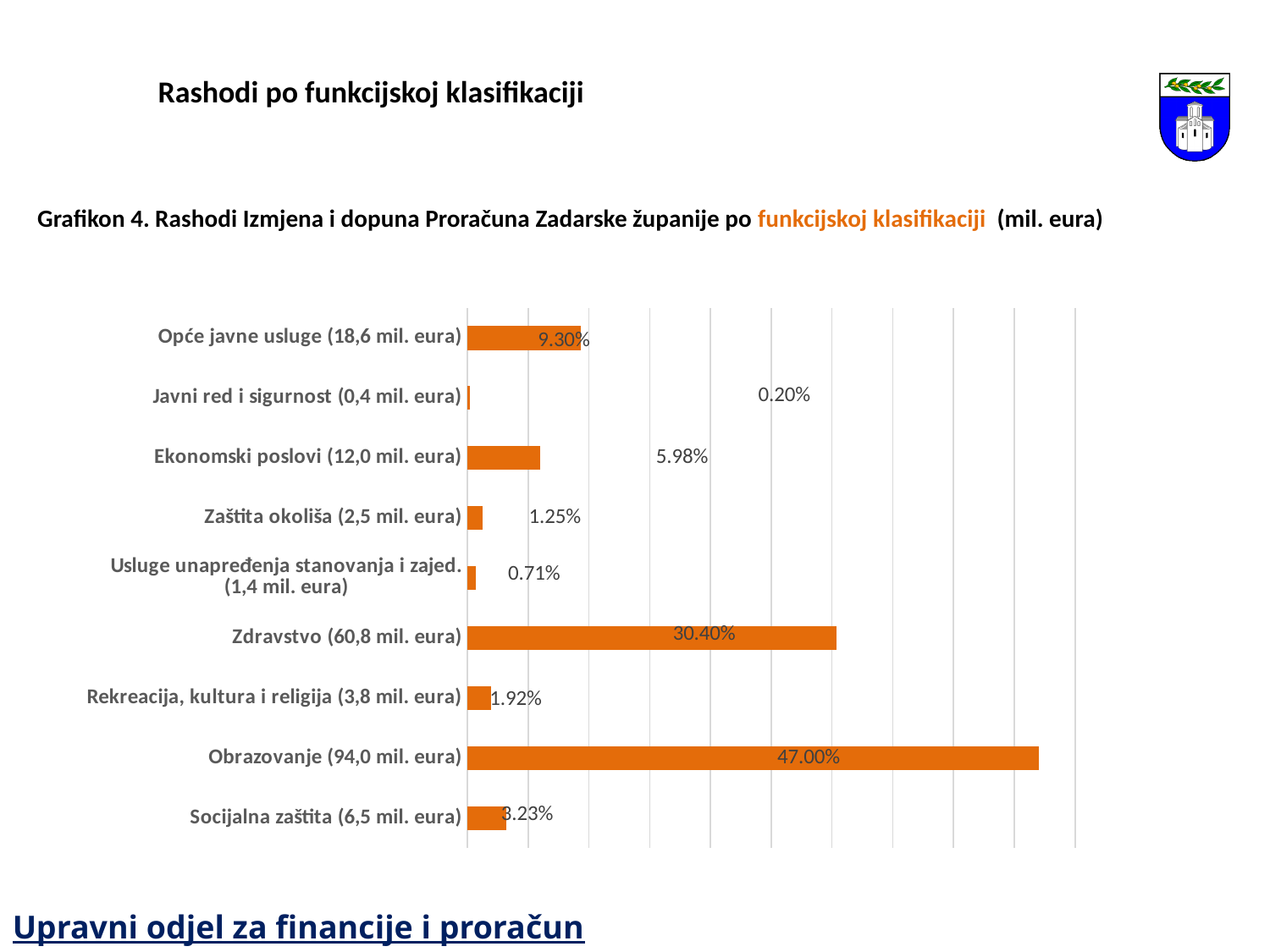
What is the value shown for Ekonomski poslovi (12,0 mil. eura)? 5.98% Which category has the lowest value? Javni red i sigurnost (0,4 mil. eura) What is the value shown for Javni red i sigurnost (0,4 mil. eura)? 0.20% What is the value shown for Obrazovanje (94,0 mil. eura)? 47.00% What is the value shown for Zdravstvo (60,8 mil. eura)? 30.40% How many categories are plotted in the chart? 9 Which category has the highest value? Obrazovanje (94,0 mil. eura) What kind of chart is shown on the slide? bar chart What is the difference between the values for Obrazovanje and Zdravstvo? 16.60% What colour are the bars in the chart? orange Which is larger, the value for Opće javne usluge or the value for Ekonomski poslovi? Opće javne usluge What is the difference between the values for Ekonomski poslovi and Socijalna zaštita? 2.75%